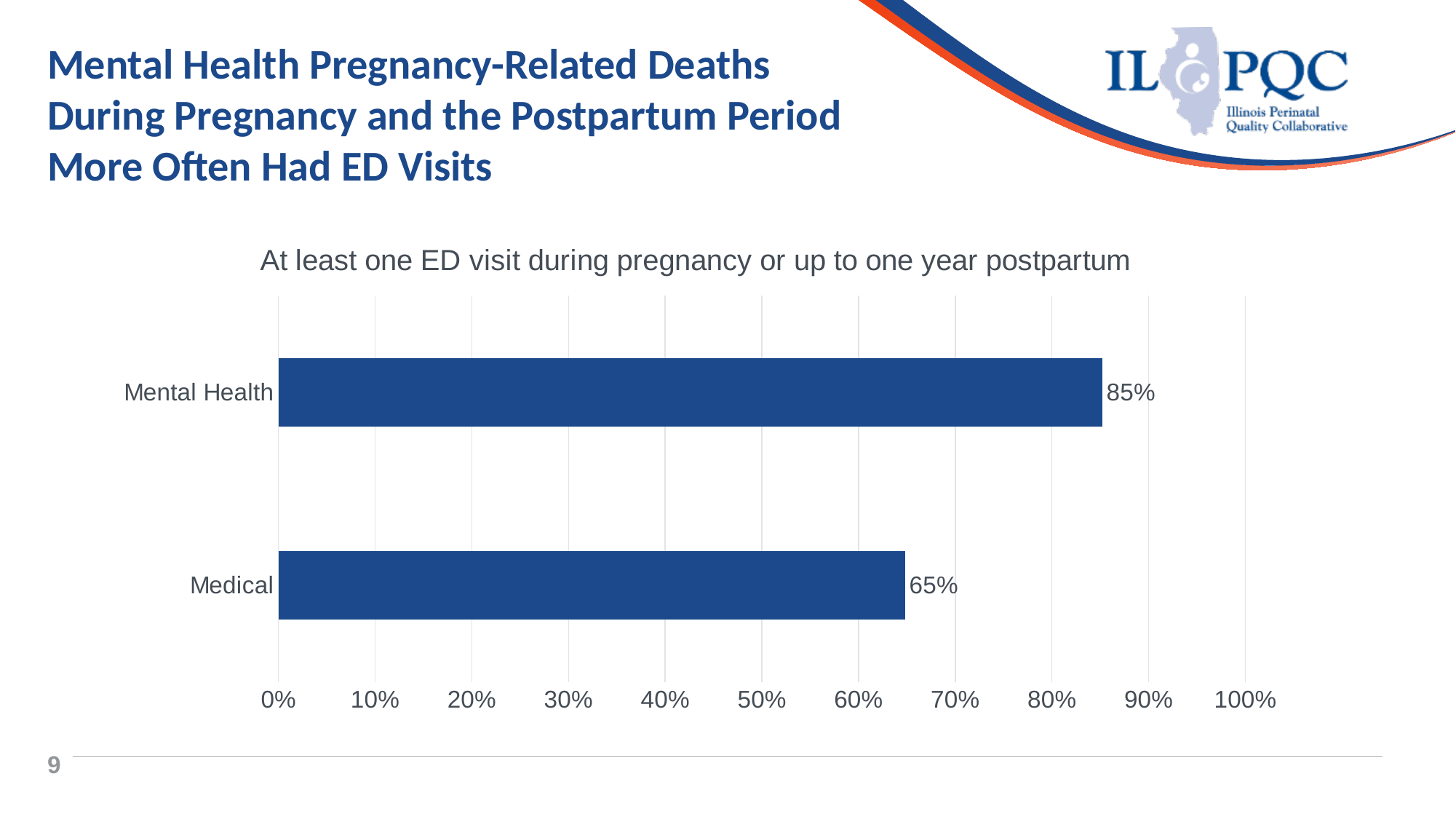
Is the value for Mental Health greater or less than 80%? greater What is the title of the chart? At least one ED visit during pregnancy or up to one year postpartum Which is larger, the value for Mental Health or the value for Medical? Mental Health What is the highest value shown on the x axis? 100% How many categories are shown in the chart? 2 What is the value for Mental Health? 85% Which category has the highest value? Mental Health Is the value for Medical greater or less than 70%? less Which category has the lowest value? Medical What is the difference between the values for Mental Health and Medical? 20% What is the value for Medical? 65% What kind of chart is shown on the slide? bar chart